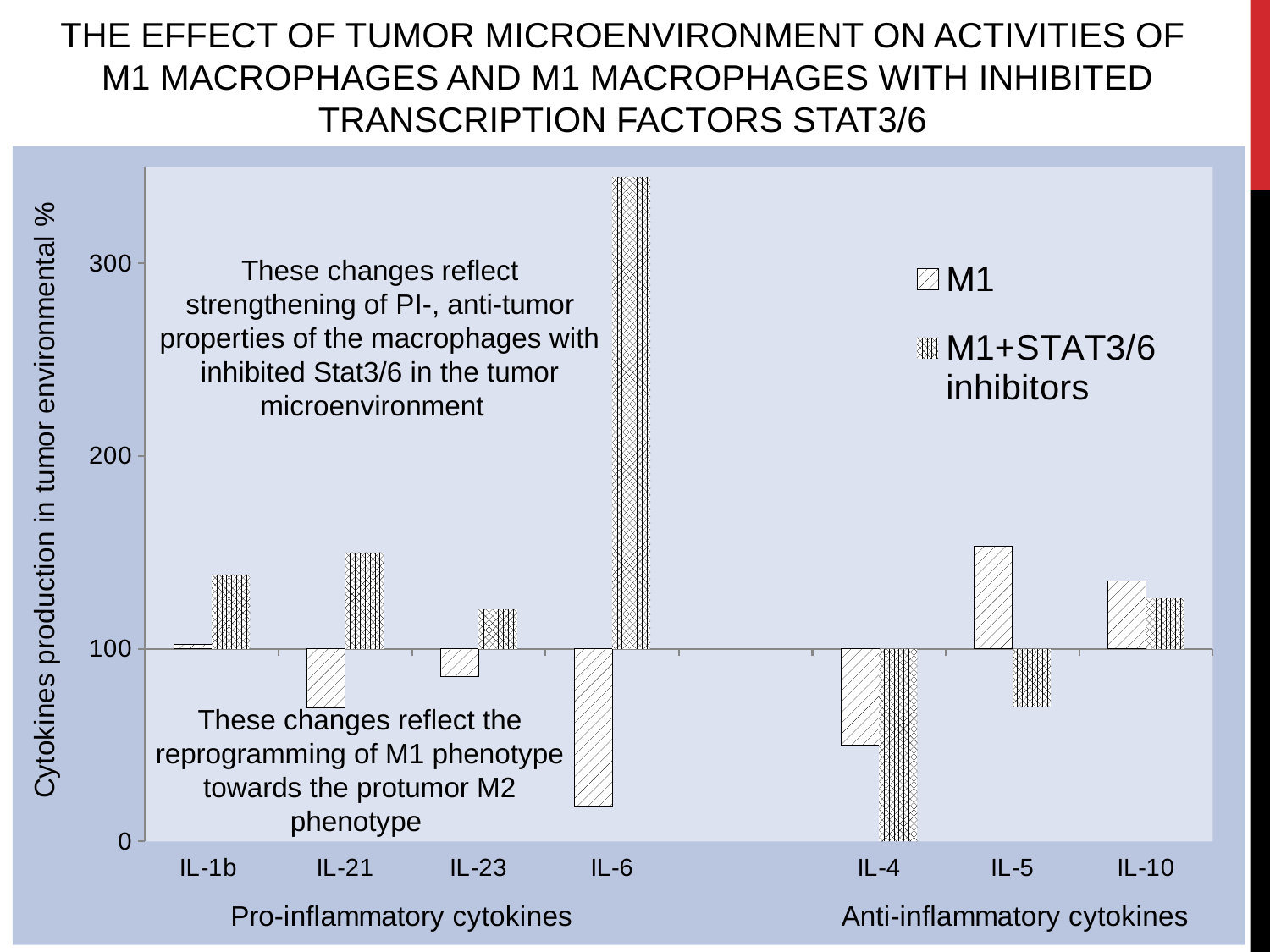
Is the M1+STAT3/6 inhibitors value for IL-5 greater or less than 100? less For IL-4, which series has the larger value, M1 or M1+STAT3/6 inhibitors? M1 For which cytokine is the M1 value highest? IL-5 How many series does the legend list? 2 For which cytokine is the M1+STAT3/6 inhibitors value lowest? IL-4 How many cytokine categories are shown on the x axis? 7 Is the M1+STAT3/6 inhibitors value for IL-6 greater or less than 300? greater What kind of chart is shown on the slide? bar chart Is the M1 value for IL-21 greater or less than 100? less For which cytokine is the M1+STAT3/6 inhibitors value highest? IL-6 For which cytokine is the M1 value lowest? IL-6 What is the label of the y axis? Cytokines production in tumor environmental %